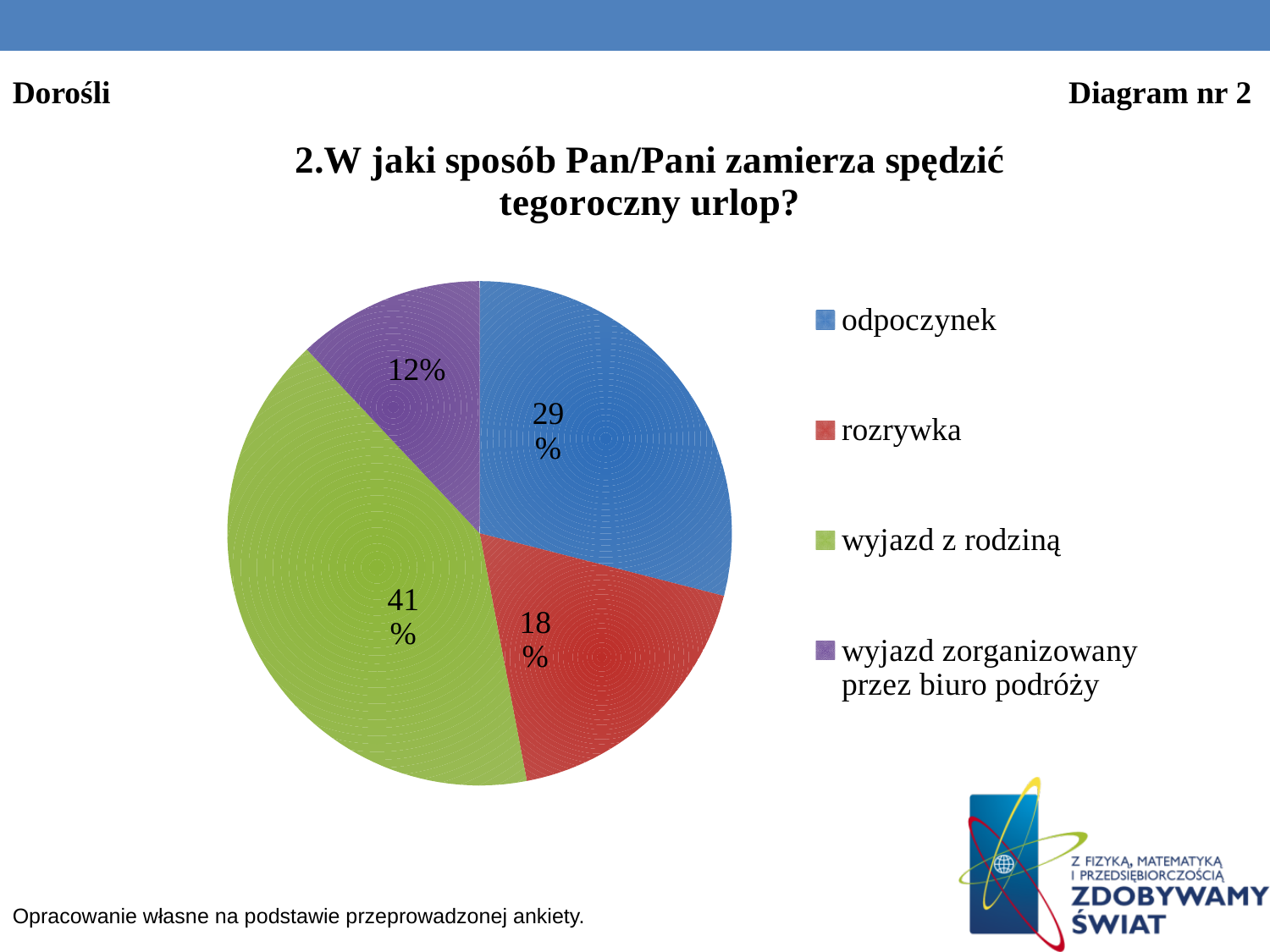
What is the difference in percentage points between "wyjazd z rodziną" and "odpoczynek"? 12 What share of the pie does "wyjazd zorganizowany przez biuro podróży" have? 12% What kind of chart is shown on the slide? pie chart Which category has the smallest slice of the pie? wyjazd zorganizowany przez biuro podróży What share of the pie does "wyjazd z rodziną" have? 41% Which is larger, the share for "odpoczynek" or the share for "rozrywka"? odpoczynek What colour is the slice for "rozrywka"? red Which category has the largest slice of the pie? wyjazd z rodziną How many categories does the pie chart show? 4 What share of the pie does "odpoczynek" have? 29% What is the title of the chart? 2.W jaki sposób Pan/Pani zamierza spędzić tegoroczny urlop?